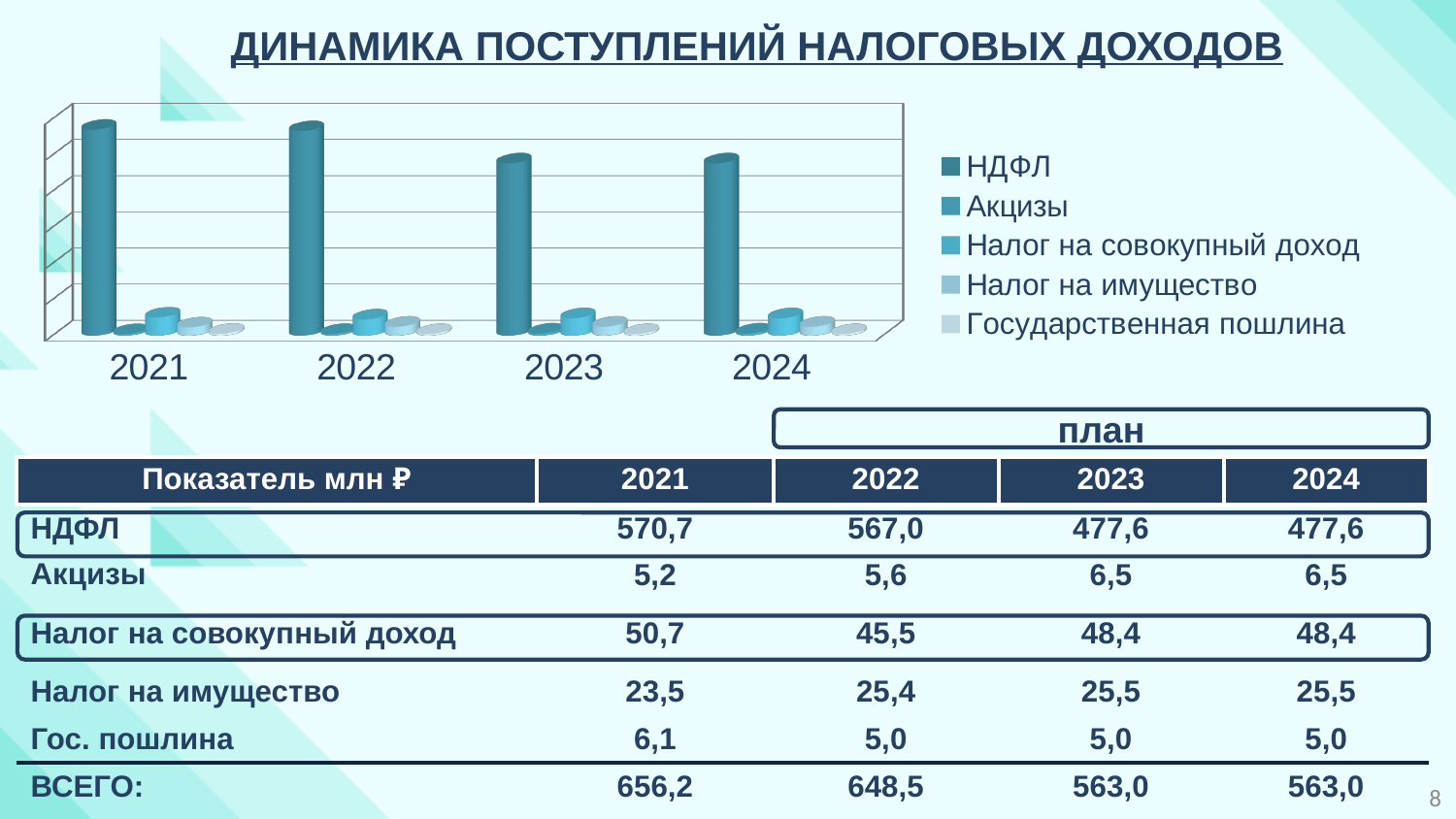
How many years are shown along the x axis of the chart? 4 What kind of chart is shown on the slide? bar chart How many series does the chart legend list? 5 Which series has the tallest bars in the chart? НДФЛ According to the table on the slide, what is the НДФЛ value for 2021? 570,7 Does the НДФЛ bar rise or fall from 2022 to 2023? fall According to the table on the slide, what is the ВСЕГО total for 2023? 563,0 According to the table on the slide, what is the difference between the НДФЛ values for 2021 and 2022? 3,7 Which is larger in the chart, the НДФЛ bar for 2021 or the НДФЛ bar for 2024? 2021 Which legend entry is listed last in the chart legend? Государственная пошлина According to the table on the slide, what is the Налог на совокупный доход value for 2022? 45,5 What is the title of the slide containing the chart? ДИНАМИКА ПОСТУПЛЕНИЙ НАЛОГОВЫХ ДОХОДОВ